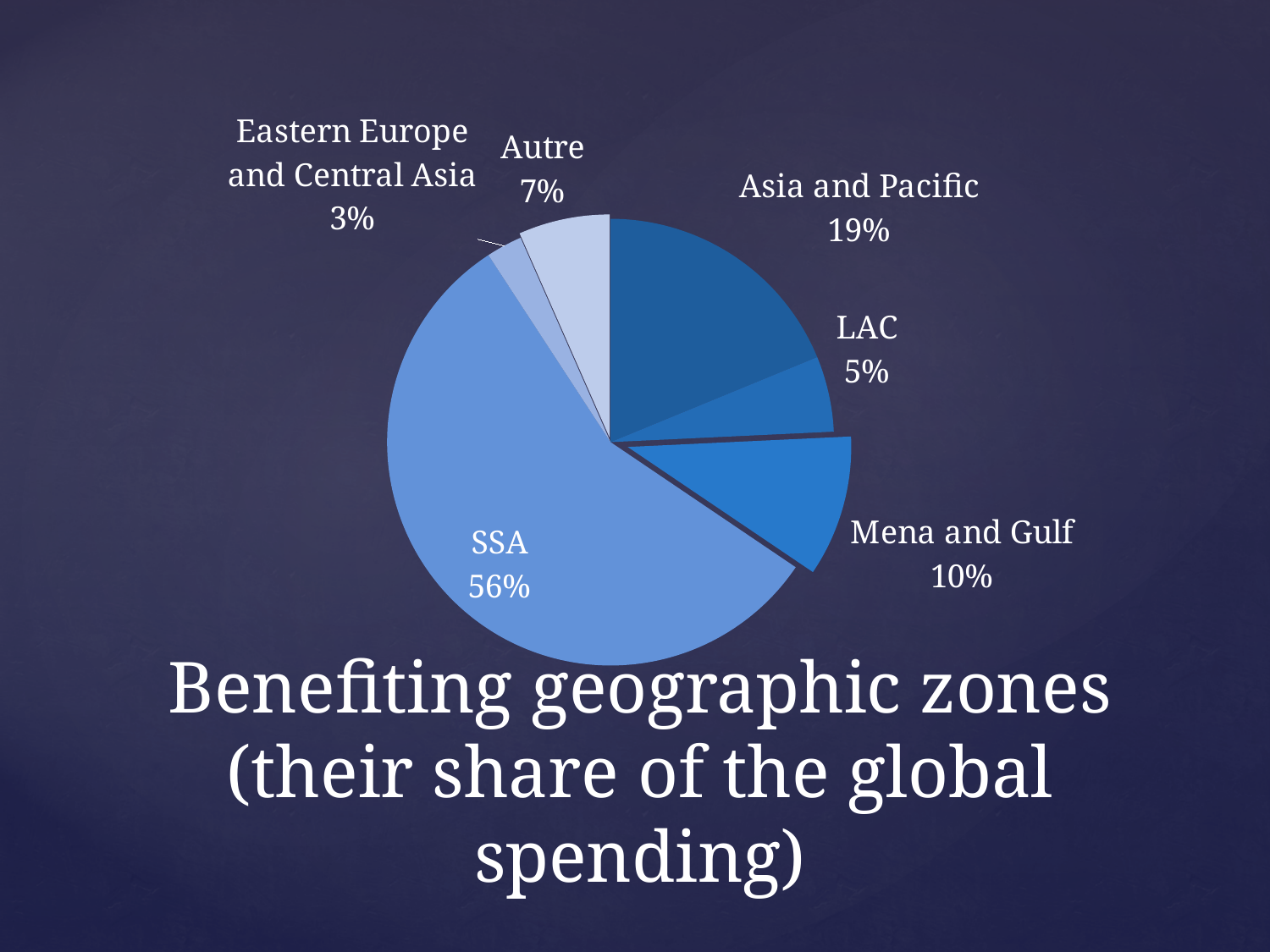
What share of global spending goes to SSA? 56% Which has a larger share of global spending, Mena and Gulf or Autre? Mena and Gulf What is the combined share of Asia and Pacific and Mena and Gulf? 29% Which geographic zone has the largest share of global spending? SSA What share of global spending goes to Eastern Europe and Central Asia? 3% How many geographic zones are shown in the pie chart? 6 What share of global spending goes to Asia and Pacific? 19% What is the difference in share between Asia and Pacific and LAC? 14 percentage points What type of chart is shown on the slide? Pie chart Which geographic zone has the smallest share of global spending? Eastern Europe and Central Asia What share of global spending goes to Mena and Gulf? 10% What is the title of the chart on the slide? Benefiting geographic zones (their share of the global spending)